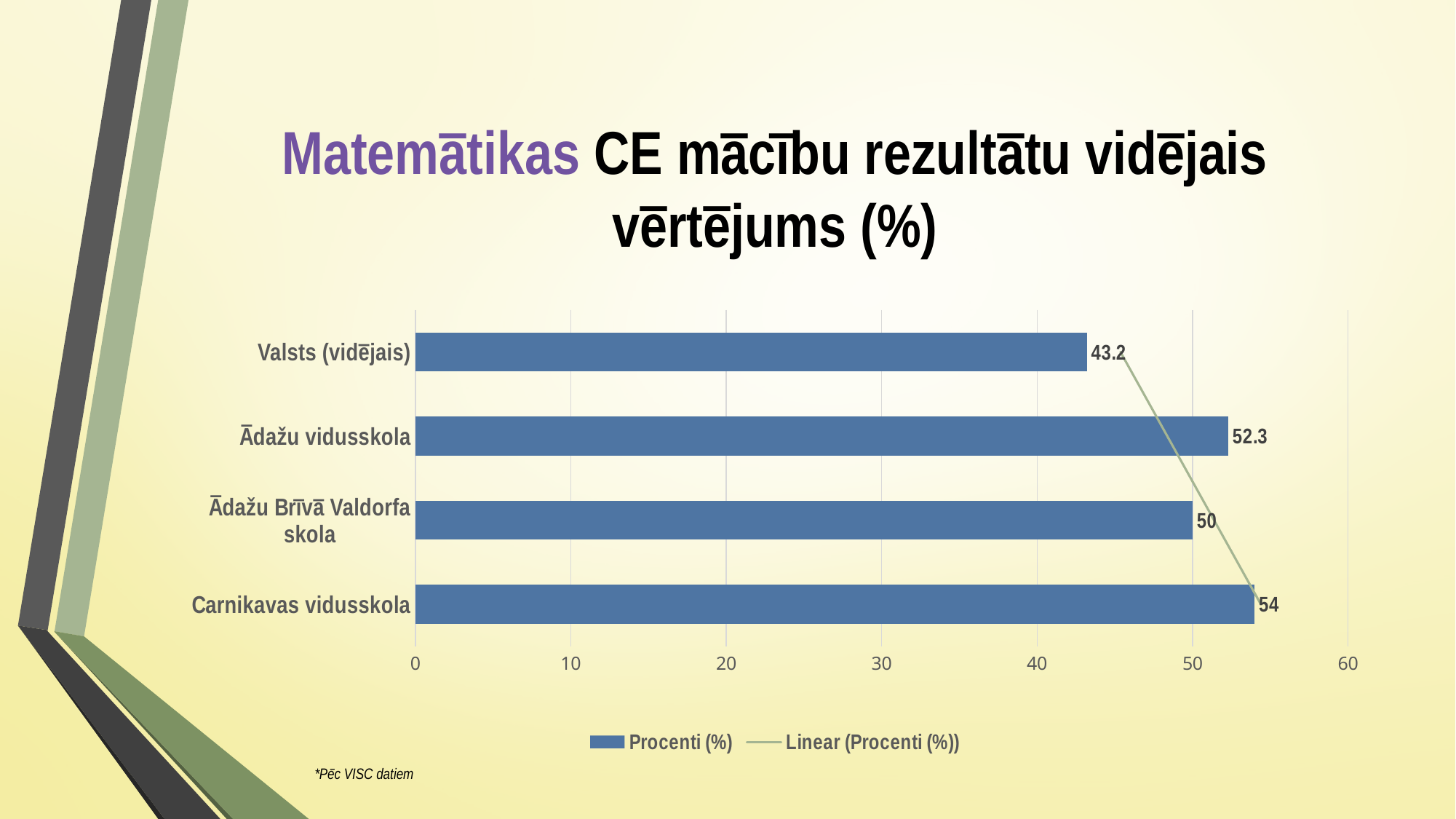
What kind of chart is shown on the slide? bar chart Which is larger, the value for Ādažu vidusskola or the value for Ādažu Brīvā Valdorfa skola? Ādažu vidusskola How many categories are shown on the chart? 4 What is the title of the chart? Matemātikas CE mācību rezultātu vidējais vērtējums (%) What is the difference between the values for Carnikavas vidusskola and Valsts (vidējais)? 10.8 Is the value for Valsts (vidējais) greater or less than 50? less Which category has the highest value? Carnikavas vidusskola Which category has the lowest value? Valsts (vidējais) What is the value for Carnikavas vidusskola? 54 What is the value for Valsts (vidējais)? 43.2 What is the value for Ādažu Brīvā Valdorfa skola? 50 What is the value for Ādažu vidusskola? 52.3